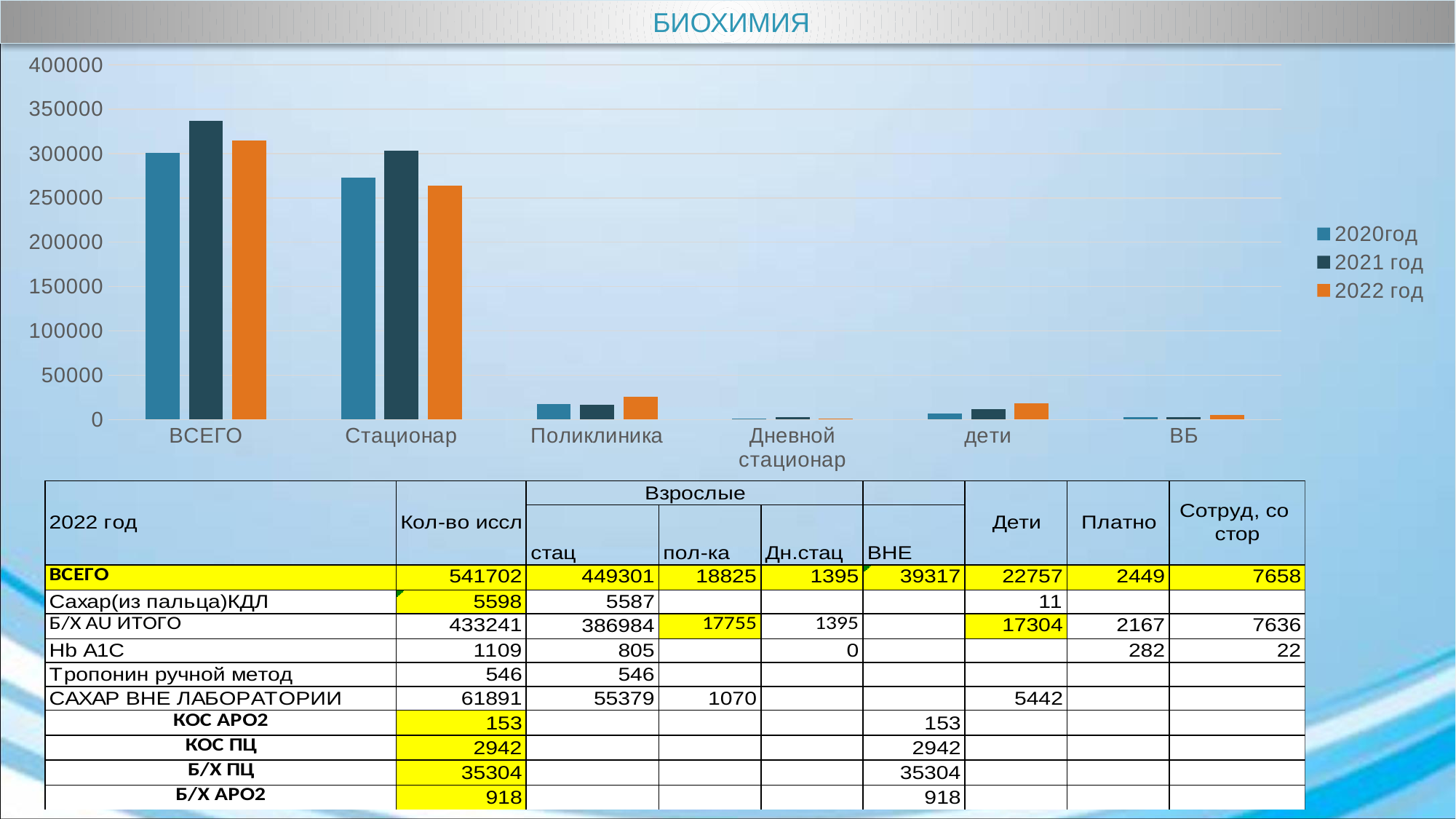
How many categories are shown on the x axis of the chart? 6 What kind of chart is shown on the slide? bar chart Which is larger in the Стационар category: the 2020год bar or the 2022 год bar? 2020год How many series does the chart legend list? 3 Which year has the highest bar in the Стационар category? 2021 год Which year has the highest bar in the Поликлиника category? 2022 год Is the value for 2022 год in the Стационар category greater or less than 250000? greater Which category has the lowest bars overall in the chart? Дневной стационар Is the value for 2022 год in the Поликлиника category greater or less than 50000? less Is the value for 2021 год in the ВСЕГО category greater or less than 300000? greater What colour are the bars for the 2022 год series? orange Which year has the highest bar in the ВСЕГО category? 2021 год